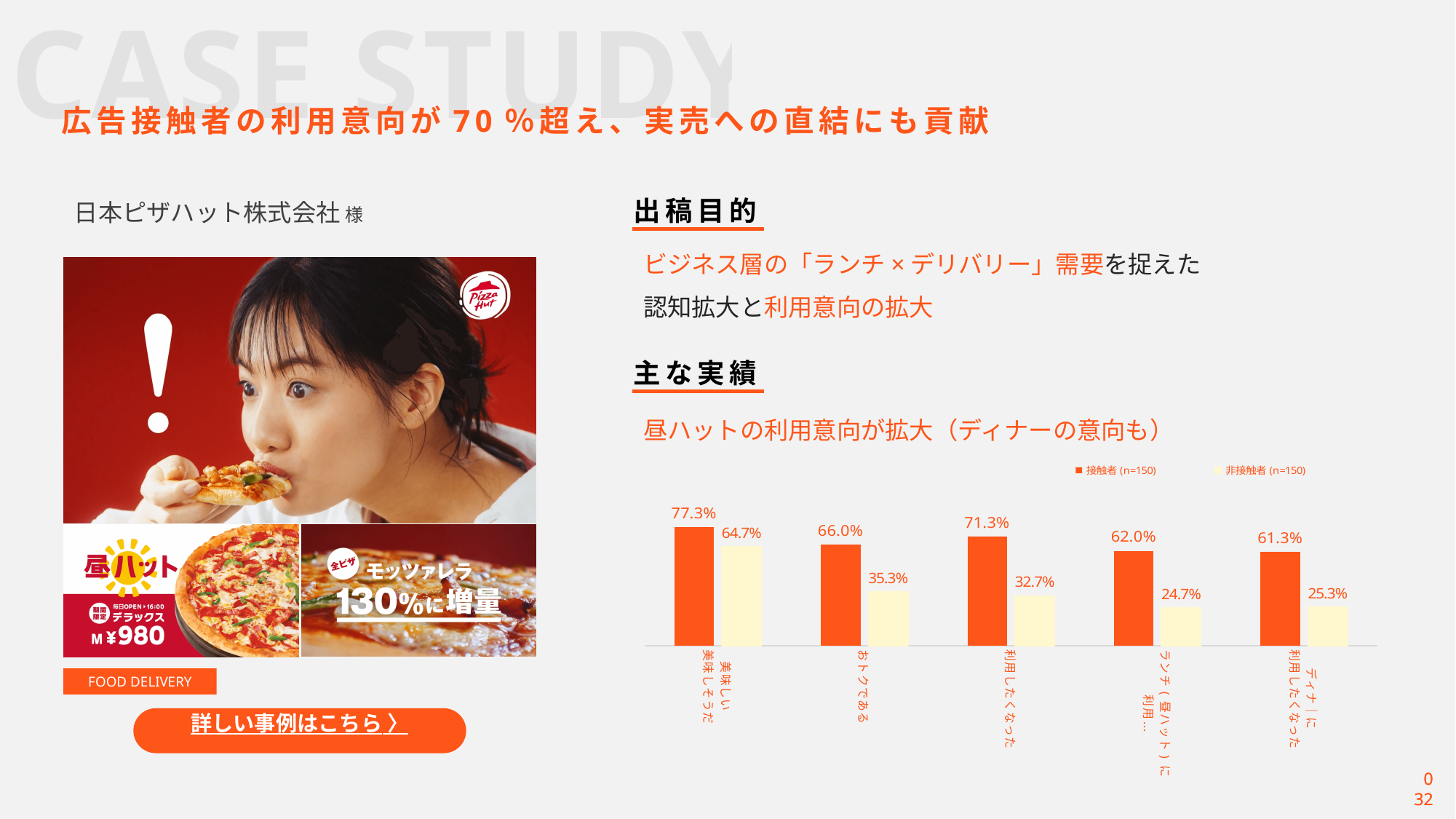
What kind of chart is shown under 主な実績? bar chart How many series does the chart legend list? 2 How many categories are shown on the chart's x axis? 5 Which category has the lowest value for 非接触者 (n=150)? ランチ（昼ハット）に利用… What is the difference between 接触者 (n=150) and 非接触者 (n=150) in the 利用したくなった category? 38.6% What is the value for 非接触者 (n=150) in the おトクである category? 35.3% What colour are the bars for the 接触者 (n=150) series? orange What is the value for 非接触者 (n=150) in the ディナーに利用したくなった category? 25.3% What is the value for 接触者 (n=150) in the 利用したくなった category? 71.3% What is the value for 接触者 (n=150) in the 美味しそうだ category? 77.3% Which category has the highest value for 接触者 (n=150)? 美味しそうだ In the おトクである category, which is larger: 接触者 (n=150) or 非接触者 (n=150)? 接触者 (n=150)